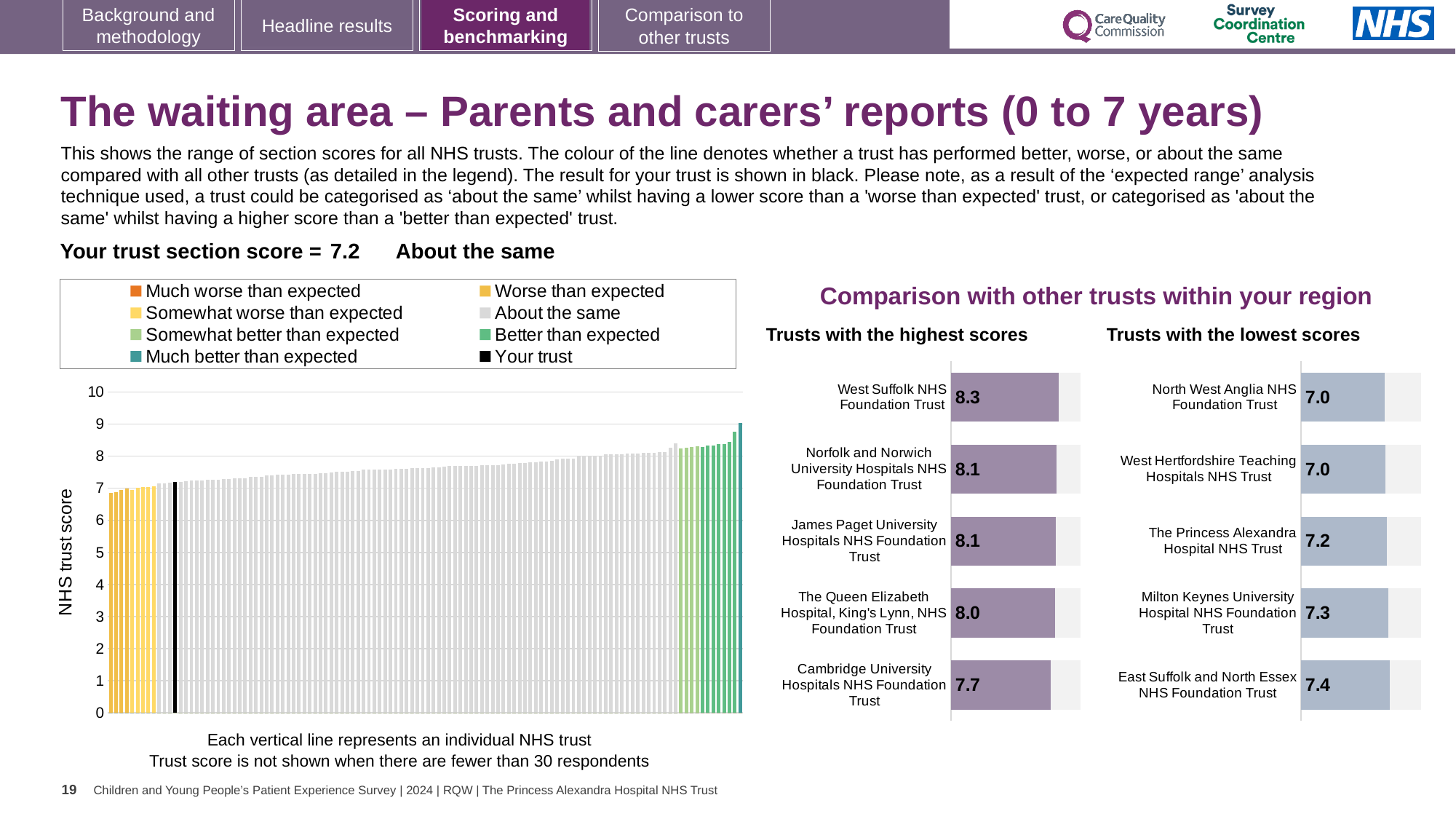
In the 'Trusts with the lowest scores' chart, which has the higher score: Milton Keynes University Hospital NHS Foundation Trust or The Princess Alexandra Hospital NHS Trust? Milton Keynes University Hospital NHS Foundation Trust In the 'Trusts with the lowest scores' chart, what is the score for The Princess Alexandra Hospital NHS Trust? 7.2 How many trusts are shown in the 'Trusts with the lowest scores' chart? 5 In the 'Trusts with the highest scores' chart, what is the score for West Suffolk NHS Foundation Trust? 8.3 In the 'NHS trust score' chart on the left, what is the section score for your trust (the black bar)? 7.2 In the 'Trusts with the lowest scores' chart, what is the score for East Suffolk and North Essex NHS Foundation Trust? 7.4 In the 'NHS trust score' chart on the left, do the bar values rise or fall from left to right? Rise In the 'Trusts with the highest scores' chart, which trust has the highest score? West Suffolk NHS Foundation Trust In the 'Trusts with the highest scores' chart, what is the difference between the scores of West Suffolk NHS Foundation Trust and Cambridge University Hospitals NHS Foundation Trust? 0.6 In the 'NHS trust score' chart on the left, is the value of the tallest bar greater or less than 8? greater What kind of chart is the large 'NHS trust score' chart on the left of the slide? Bar chart In the 'Trusts with the highest scores' chart, what is the score for The Queen Elizabeth Hospital, King's Lynn, NHS Foundation Trust? 8.0